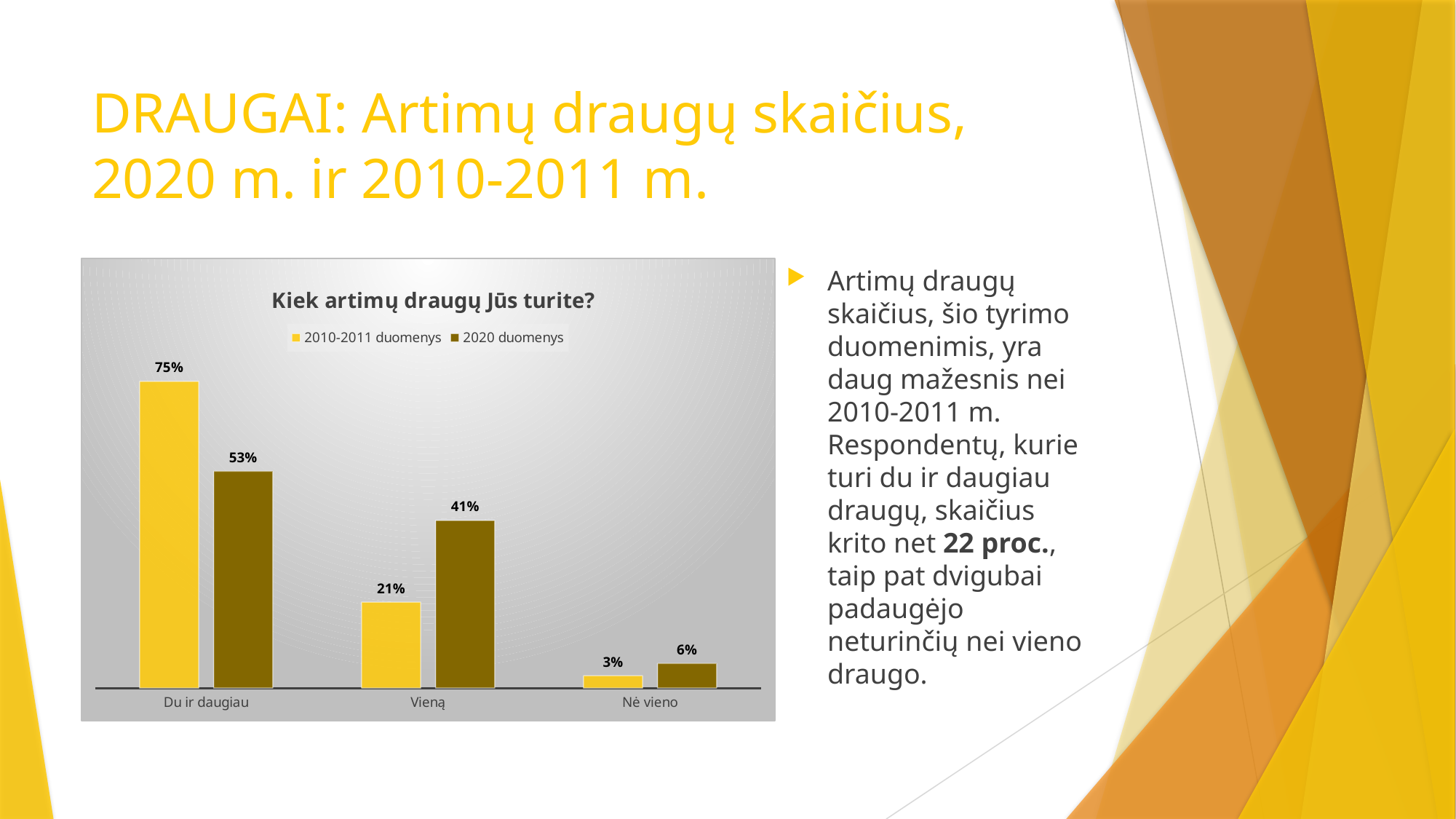
What is the difference between the 2020 duomenys and 2010-2011 duomenys values for "Vieną"? 20% How many categories are shown on the x axis? 3 Which category has the lowest value in the 2010-2011 duomenys series? Nė vieno For "Nė vieno", which series has the larger value: 2010-2011 duomenys or 2020 duomenys? 2020 duomenys Which category has the highest value in the 2020 duomenys series? Du ir daugiau What is the difference between the 2010-2011 duomenys and 2020 duomenys values for "Du ir daugiau"? 22% What is the value for "Vieną" in the 2020 duomenys series? 41% What is the title of the chart? Kiek artimų draugų Jūs turite? How many series does the legend list? 2 What is the value for "Nė vieno" in the 2010-2011 duomenys series? 3% What kind of chart is shown on the slide? Bar chart What is the value for "Du ir daugiau" in the 2010-2011 duomenys series? 75%